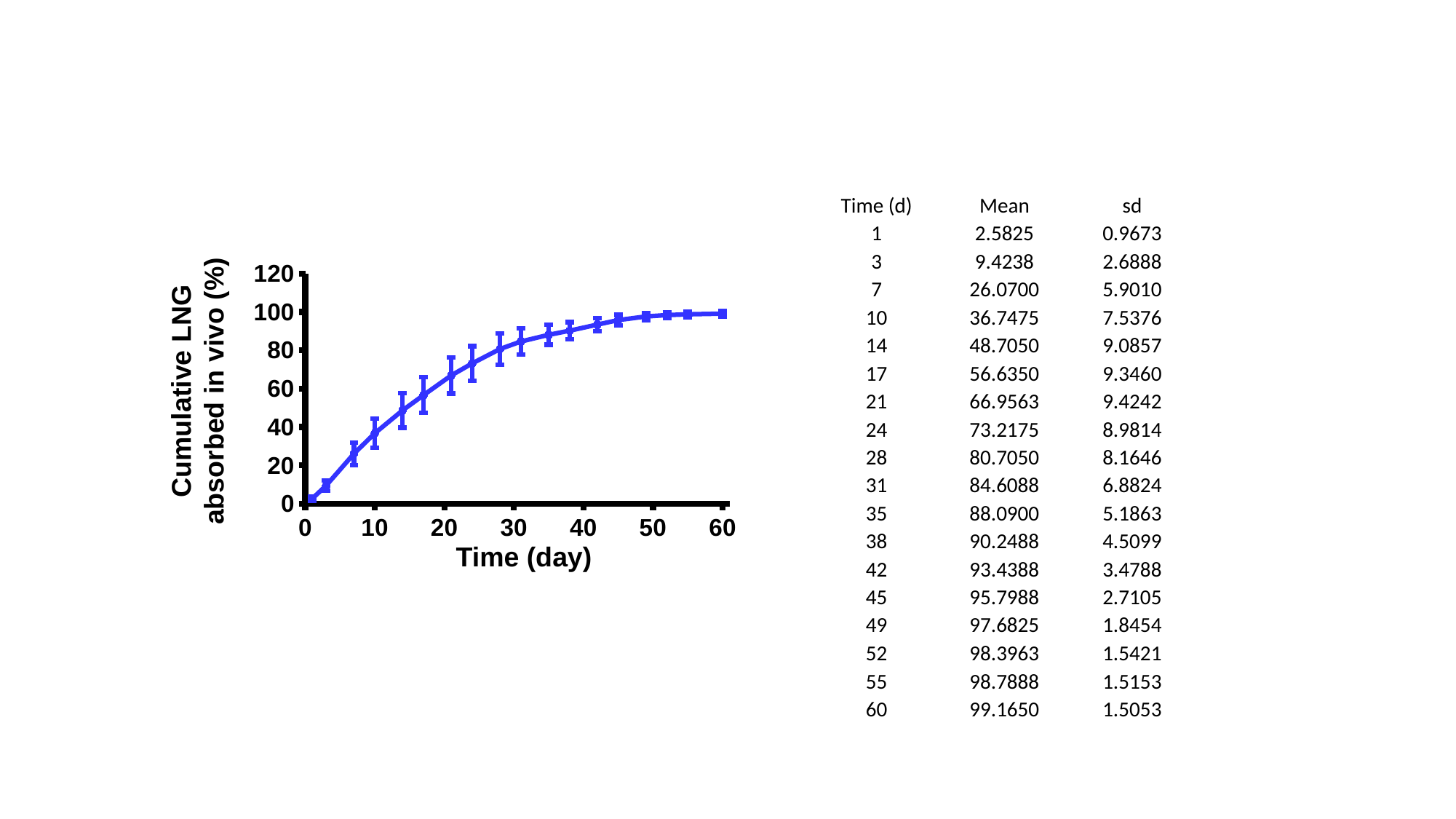
At which time point is the mean cumulative LNG absorbed highest? 60 What kind of chart is shown on the slide? line chart What is the label of the y axis of the chart? Cumulative LNG absorbed in vivo (%) Is the value for day 28 greater or less than 80? greater What is the label of the x axis of the chart? Time (day) According to the table, what is the mean cumulative LNG absorbed at day 14? 48.7050 According to the table, what is the sd at day 21? 9.4242 Do the plotted values rise or fall as time increases along the x axis? rise At which time point is the mean cumulative LNG absorbed lowest? 1 According to the table, what is the mean cumulative LNG absorbed at day 60? 99.1650 Is the value for day 10 greater or less than 40? less How many time points are listed in the table? 18